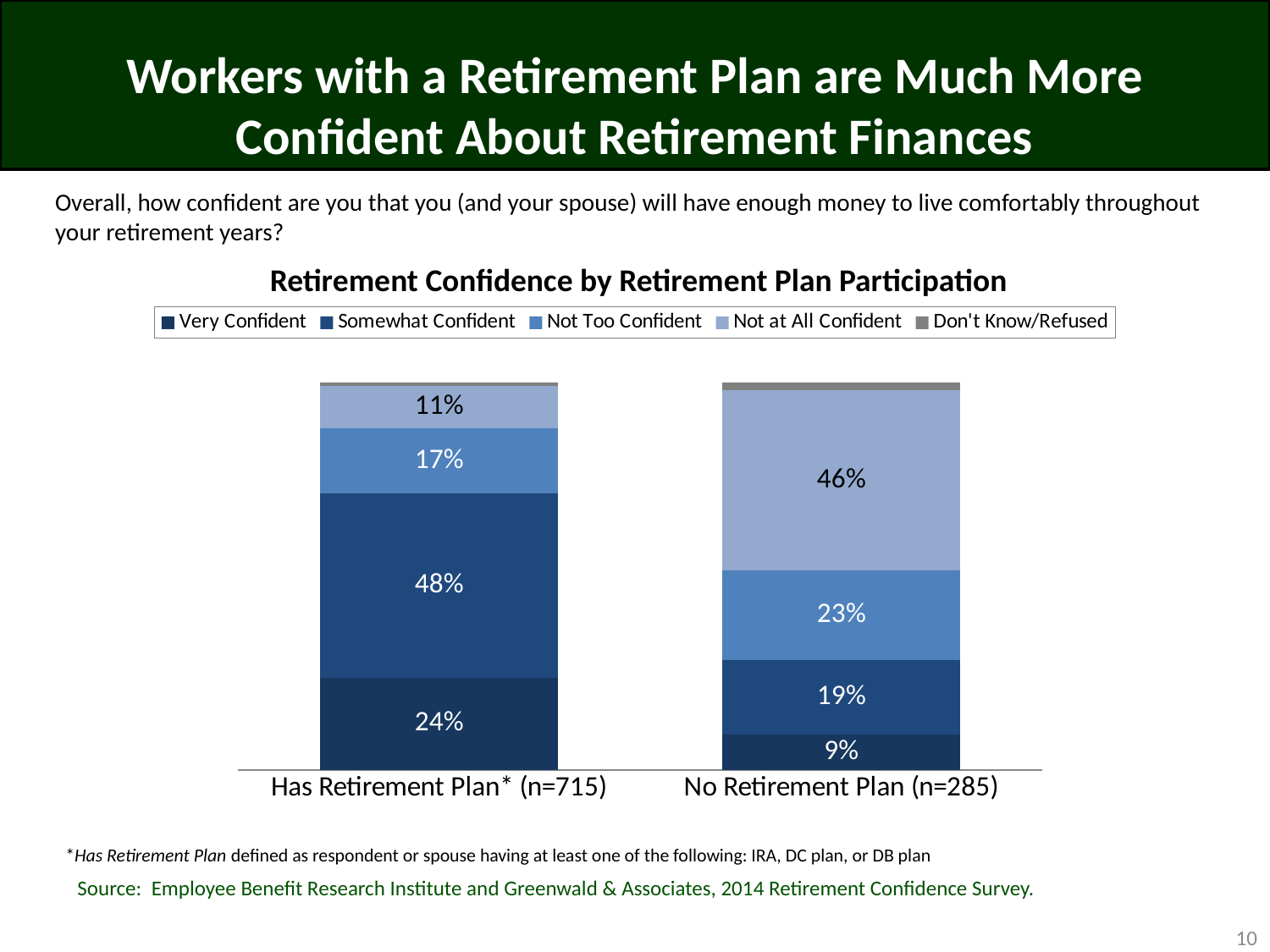
What is the Somewhat Confident value for the No Retirement Plan (n=285) bar? 19% How many bars (groups) are shown in the chart? 2 Which group has a larger Not Too Confident share: Has Retirement Plan or No Retirement Plan? No Retirement Plan What is the Not Too Confident value for the Has Retirement Plan* (n=715) bar? 17% What is the difference in percentage points between the Not at All Confident shares of the two groups? 35 What percentage of workers with no retirement plan are Not at All Confident? 46% How many percentage points higher is the Somewhat Confident share for workers with a retirement plan than for those without? 29 What type of chart is shown on the slide? Stacked bar chart Which confidence level is the largest segment in the Has Retirement Plan* (n=715) bar? Somewhat Confident What percentage of workers with a retirement plan are Very Confident? 24% How many series does the legend list? 5 Which labeled confidence level is the smallest segment in the No Retirement Plan (n=285) bar? Very Confident